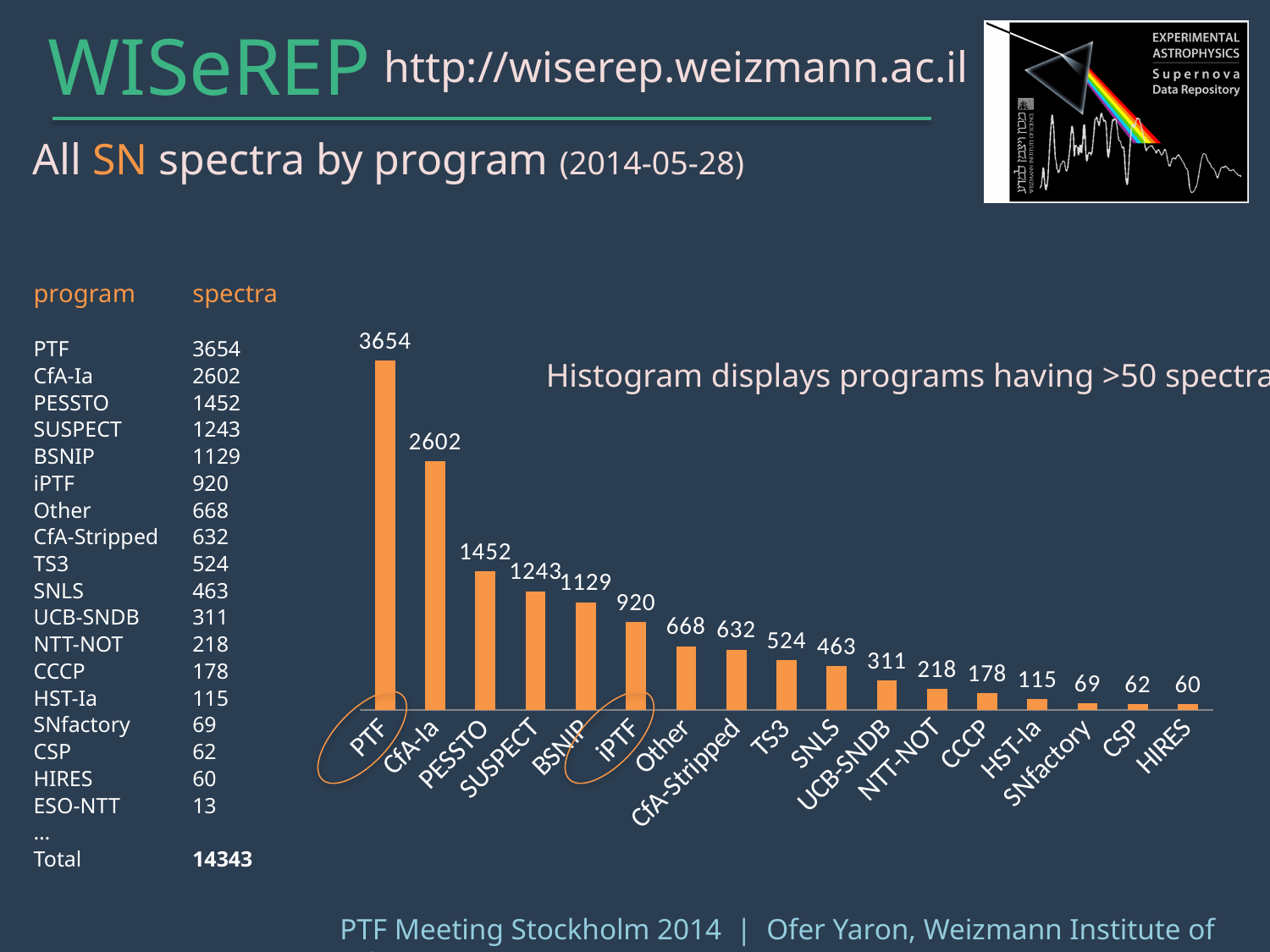
Which program has the lowest number of spectra in the chart? HIRES What is the value for PTF in the chart? 3654 Do the values rise or fall from left to right along the x axis? fall What is the value for UCB-SNDB in the chart? 311 What is the difference between the values for PTF and CfA-Ia? 1052 Which program has the highest number of spectra in the chart? PTF What kind of chart is shown on the slide? bar chart Which is larger, the value for TS3 or the value for SNLS? TS3 How many programs are shown in the chart? 17 What is the difference between the values for iPTF and Other? 252 What is the value for BSNIP in the chart? 1129 Which is larger, the value for SUSPECT or the value for PESSTO? PESSTO